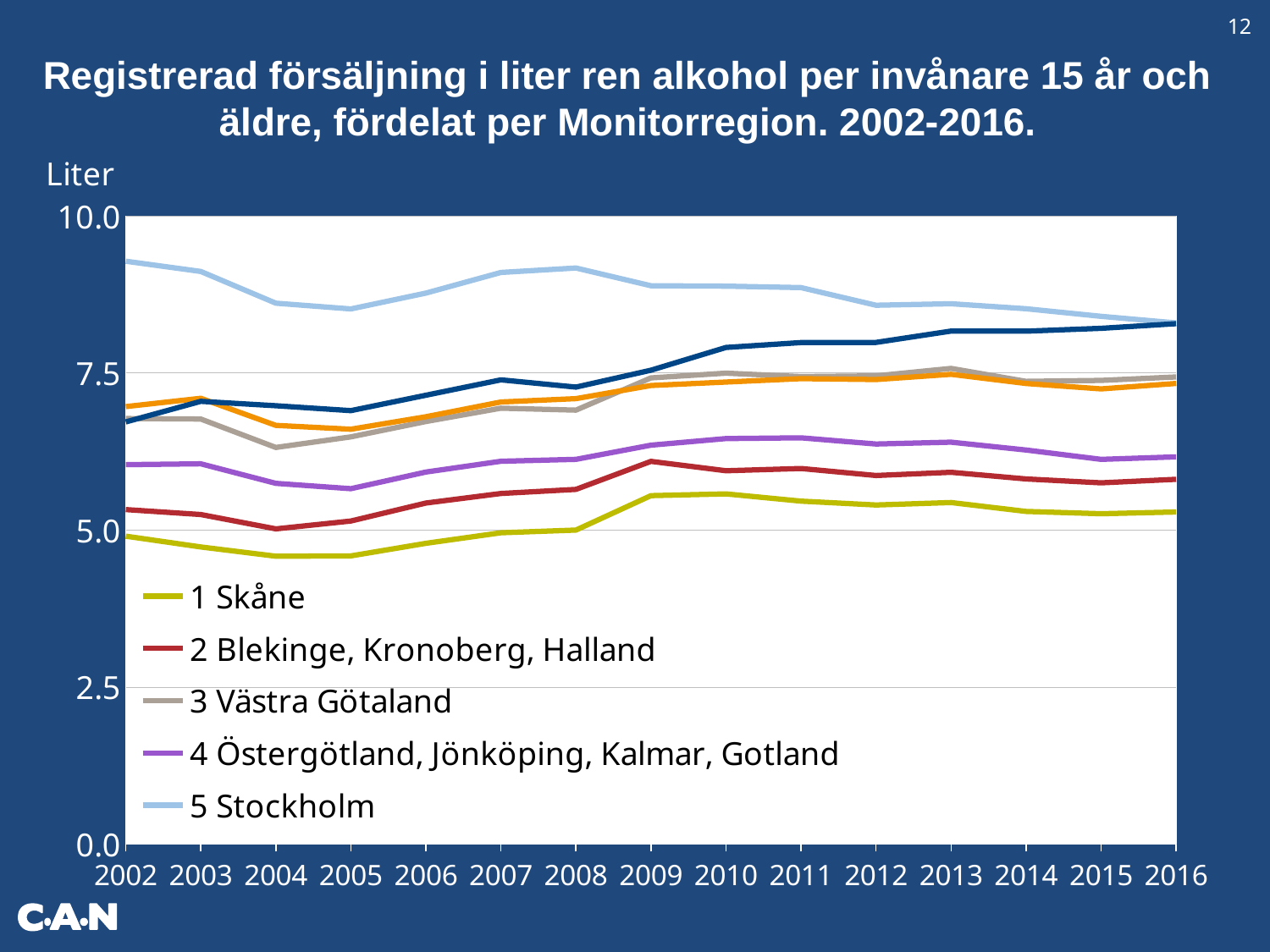
Which series listed in the legend has the highest value in 2016? 5 Stockholm What unit is shown on the y axis of the chart? Liter What kind of chart is shown on the slide? line chart How many years are shown along the x axis of the chart? 15 Which series listed in the legend has the lowest value in 2002? 1 Skåne Is the value for 3 Västra Götaland in 2004 greater or less than 7.5? less How many series does the chart's legend list? 5 In 2010, which is larger: the value for 5 Stockholm or the value for 1 Skåne? 5 Stockholm Does the value for 5 Stockholm rise or fall from 2002 to 2016? fall Is the value for 1 Skåne in 2009 greater or less than 5.0? greater Is the value for 1 Skåne in 2004 greater or less than 5.0? less